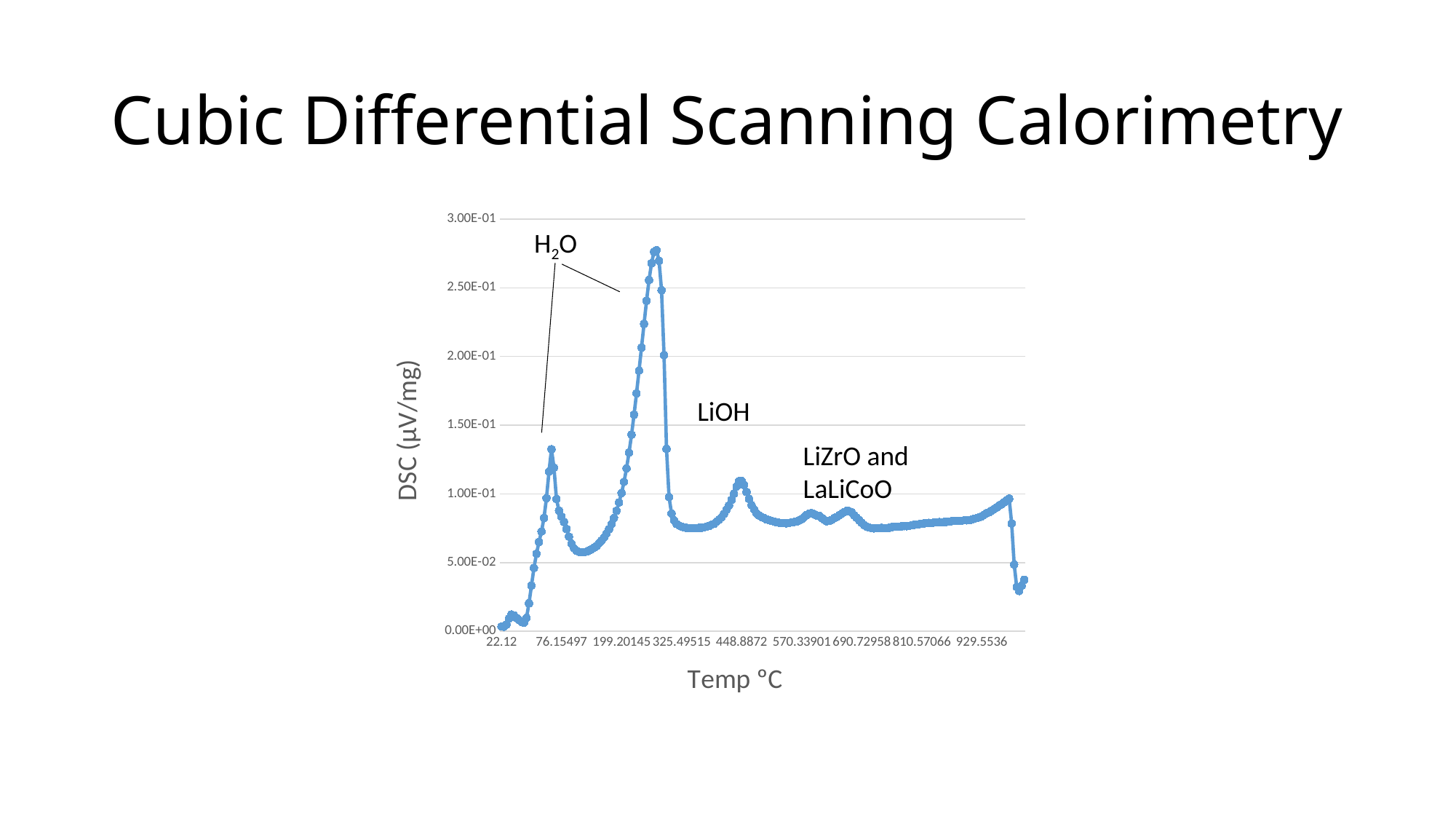
What kind of chart is shown on the slide? line chart Is the DSC value at the peak labelled H2O greater or less than 1.00E-01? greater Which labelled peak reaches the highest DSC value? H2O Which peak is higher, the one labelled H2O or the one labelled LiOH? H2O Do the DSC values rise or fall immediately after the peak labelled LiOH as temperature increases? fall Is the DSC value at the peak labelled LiOH greater or less than 2.50E-01? less How many tick labels are shown on the x axis? 9 What is the title of the slide's chart? Cubic Differential Scanning Calorimetry What is the highest value shown on the y axis? 3.00E-01 What is the label of the y axis? DSC (µV/mg) Is the DSC value at the peak labelled LiZrO and LaLiCoO greater or less than 1.00E-01? less